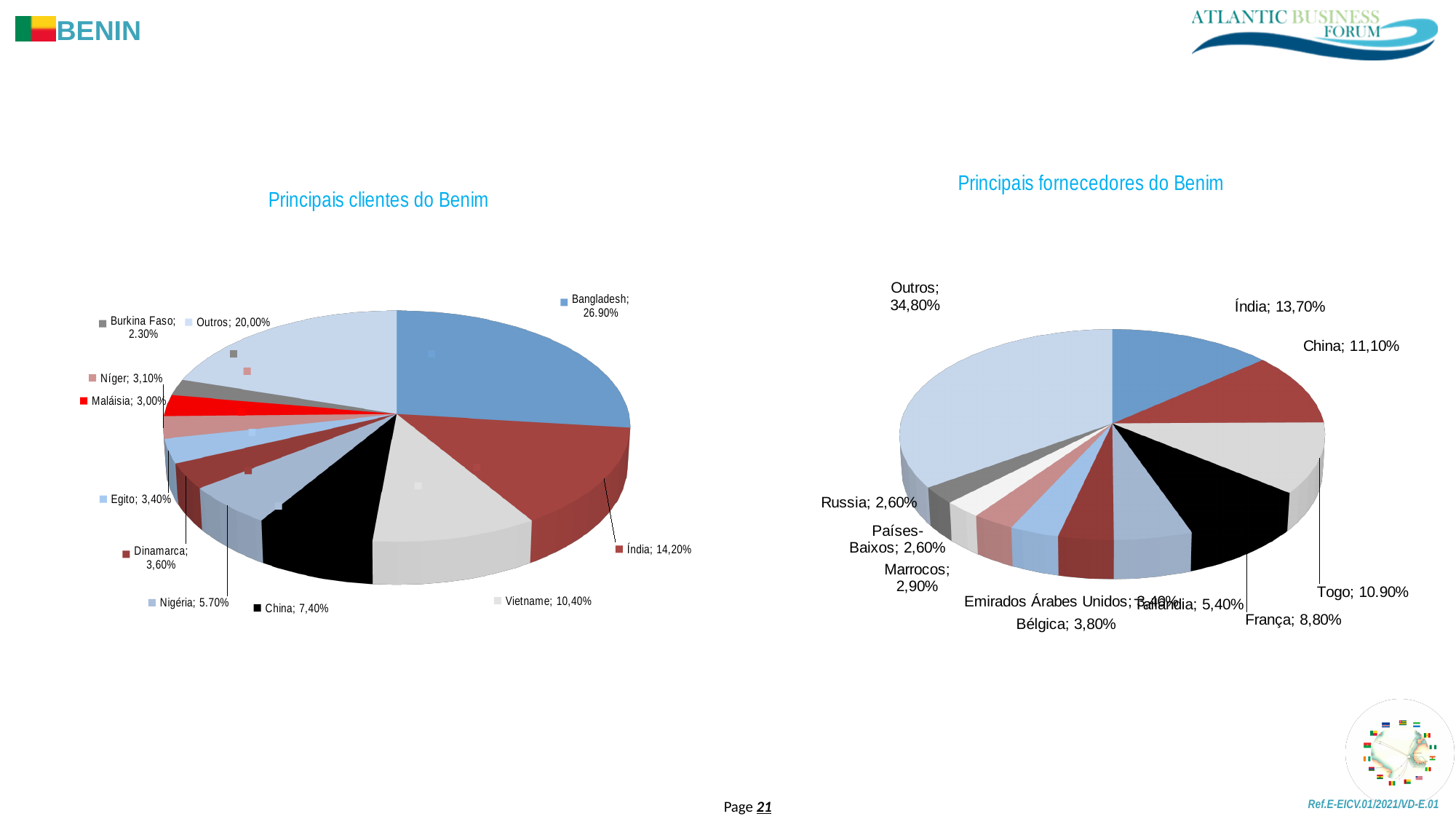
What kind of chart is 'Principais clientes do Benim'? pie chart In the 'Principais clientes do Benim' chart, what is the value for Vietname? 10,40% In the 'Principais fornecedores do Benim' chart, which of Índia or Togo has the larger share? Índia In the 'Principais fornecedores do Benim' chart, what is the value for França? 8,80% In the 'Principais fornecedores do Benim' chart, what is the value for Outros? 34,80% In the 'Principais clientes do Benim' chart, which of Nigéria or China has the larger share? China In the 'Principais clientes do Benim' chart, which named country (excluding Outros) has the smallest share? Burkina Faso In the 'Principais clientes do Benim' chart, what is the value for Bangladesh? 26.90% In the 'Principais clientes do Benim' chart, how many slices does the pie have? 11 In the 'Principais clientes do Benim' chart, what is the difference between the shares of Índia and China? 6,80% In the 'Principais fornecedores do Benim' chart, which slice is the largest? Outros What is the title of the chart on the right side of the slide? Principais fornecedores do Benim